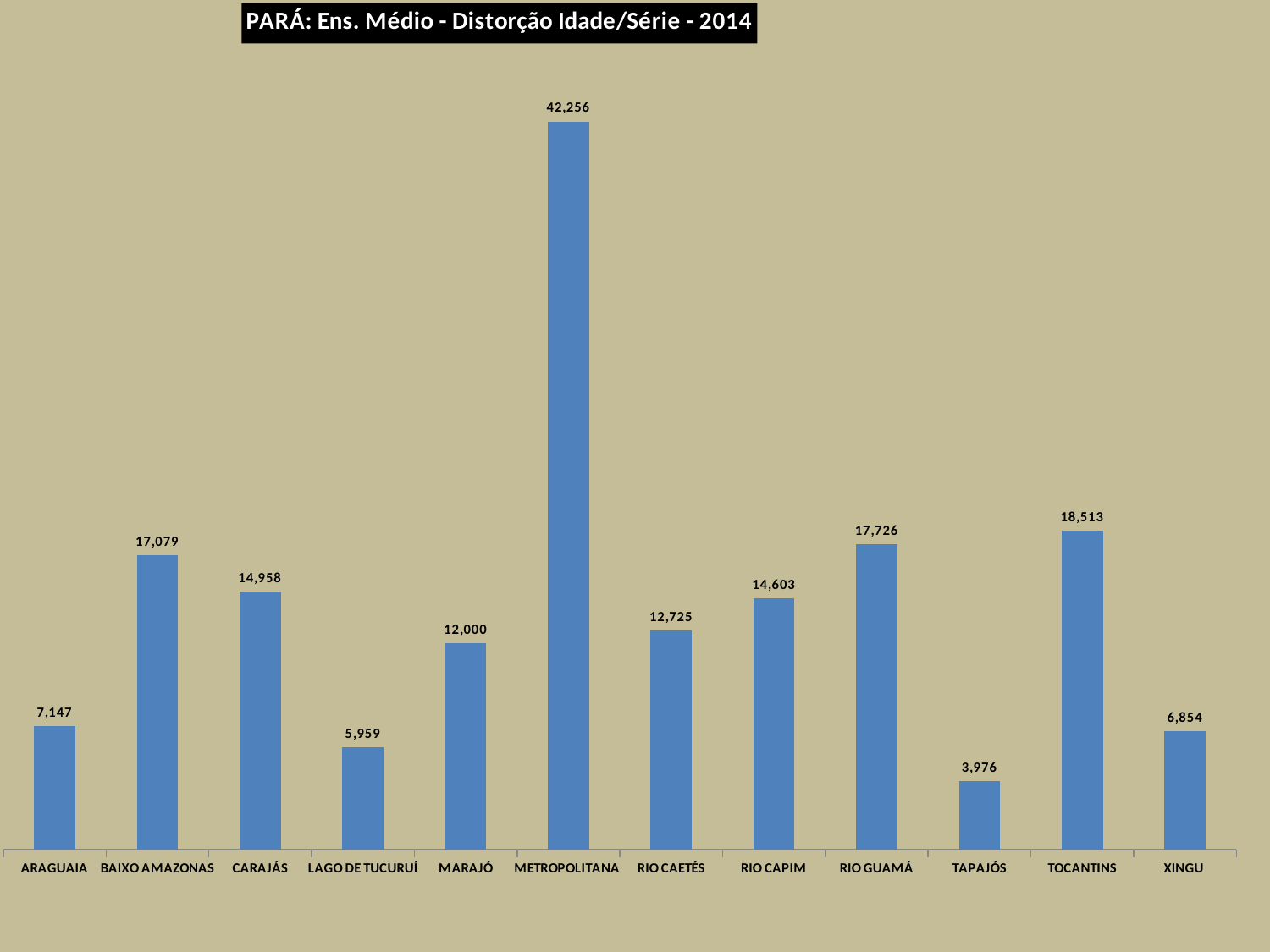
What is the value for TAPAJÓS? 3,976 How many categories are shown on the x axis? 12 Which is larger, the value for ARAGUAIA or the value for XINGU? ARAGUAIA What is the difference between the values for TOCANTINS and RIO GUAMÁ? 787 What is the difference between the values for BAIXO AMAZONAS and CARAJÁS? 2,121 What is the title of the chart? PARÁ: Ens. Médio - Distorção Idade/Série - 2014 What kind of chart is shown on the slide? Bar chart Which is larger, the value for RIO CAPIM or the value for RIO CAETÉS? RIO CAPIM What is the value for MARAJÓ? 12,000 Which category has the highest value? METROPOLITANA What is the value for METROPOLITANA? 42,256 Which category has the lowest value? TAPAJÓS